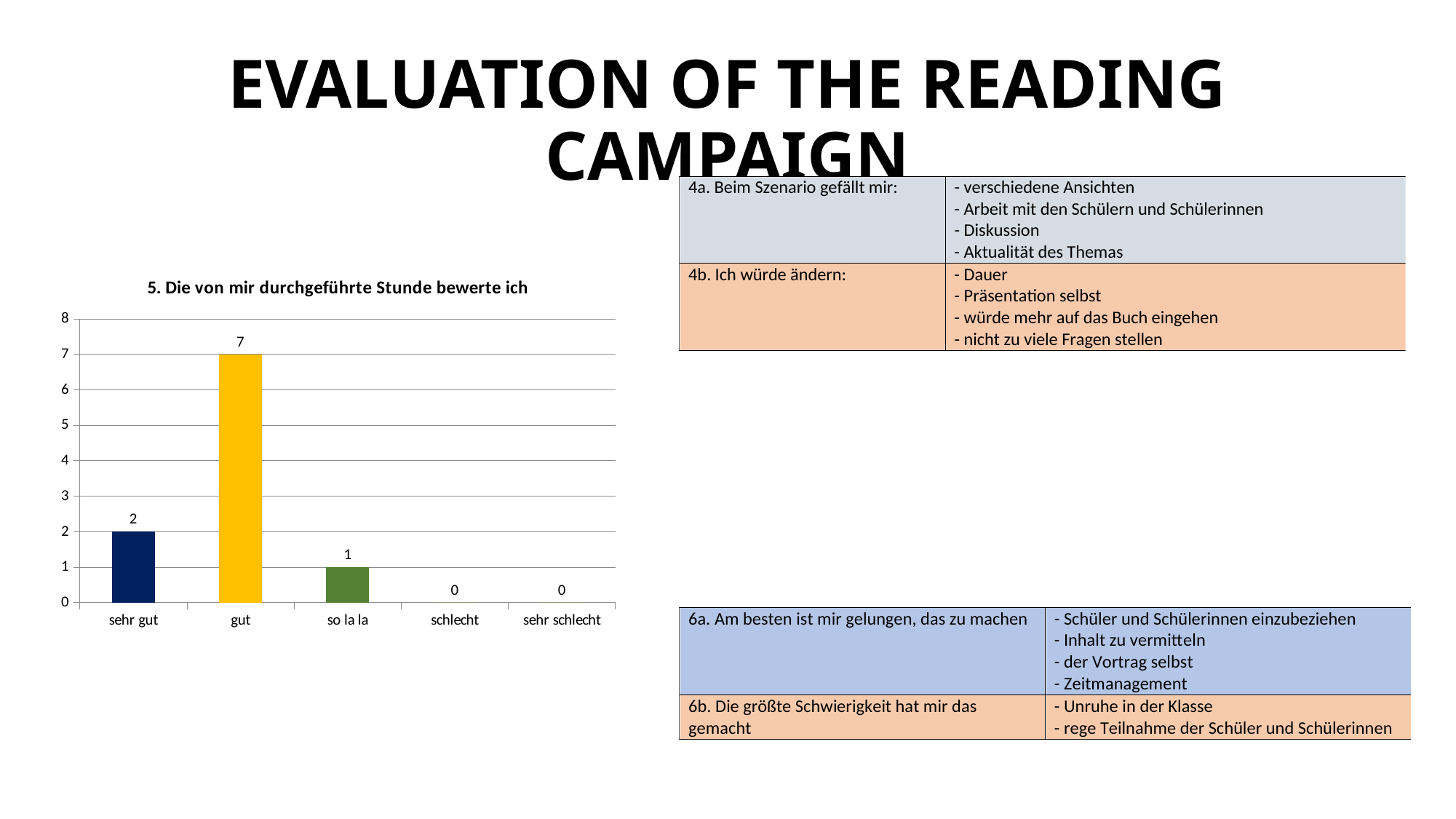
How many categories are shown on the x axis? 5 What is the value for "gut"? 7 What is the difference between the values for "gut" and "sehr gut"? 5 Which category has the highest value? gut What is the value for "schlecht"? 0 What is the value for "sehr gut"? 2 What colour is the bar for "gut"? yellow What kind of chart is shown on the slide? bar chart What is the value for "so la la"? 1 Which is larger, the value for "sehr gut" or the value for "so la la"? sehr gut What is the title of the chart? 5. Die von mir durchgeführte Stunde bewerte ich Is the value for "gut" greater or less than 5? greater